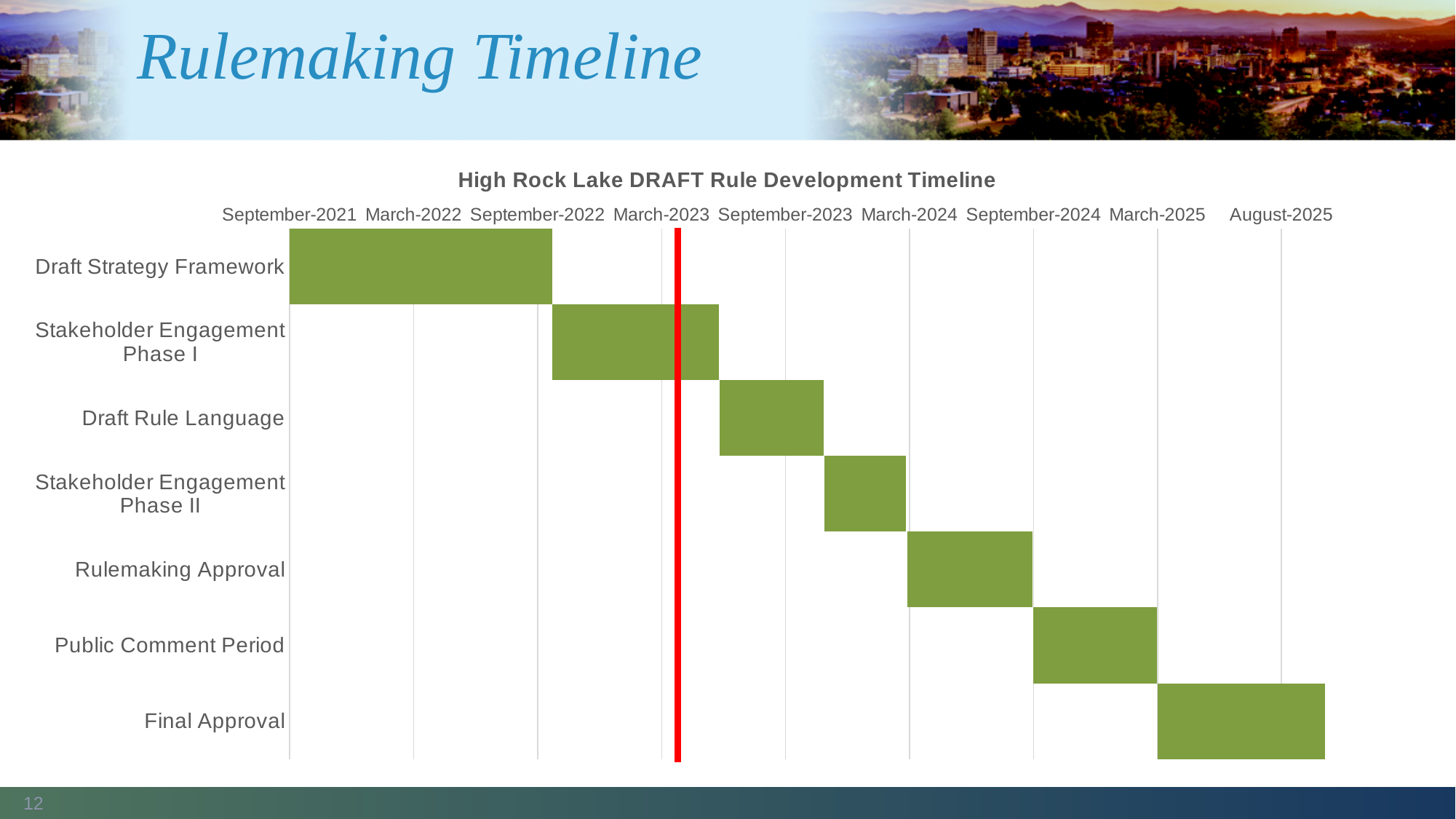
At which axis date does the Rulemaking Approval bar begin? March-2024 What kind of chart is shown on the slide? Bar chart (Gantt timeline) At which axis date does the Final Approval bar begin? March-2025 At which axis date does the Draft Strategy Framework bar begin? September-2021 Which bar is longer, Draft Strategy Framework or Draft Rule Language? Draft Strategy Framework How many tasks are listed on the chart? 7 At which axis date does the Draft Strategy Framework bar end? September-2022 Which task is the last one listed on the chart? Final Approval At which axis date does the Public Comment Period bar end? March-2025 What is the title of the chart? High Rock Lake DRAFT Rule Development Timeline Which task has the longest bar on the chart? Draft Strategy Framework Do the task bars move later in time going down the list of tasks? Yes, each task starts later than the one above it